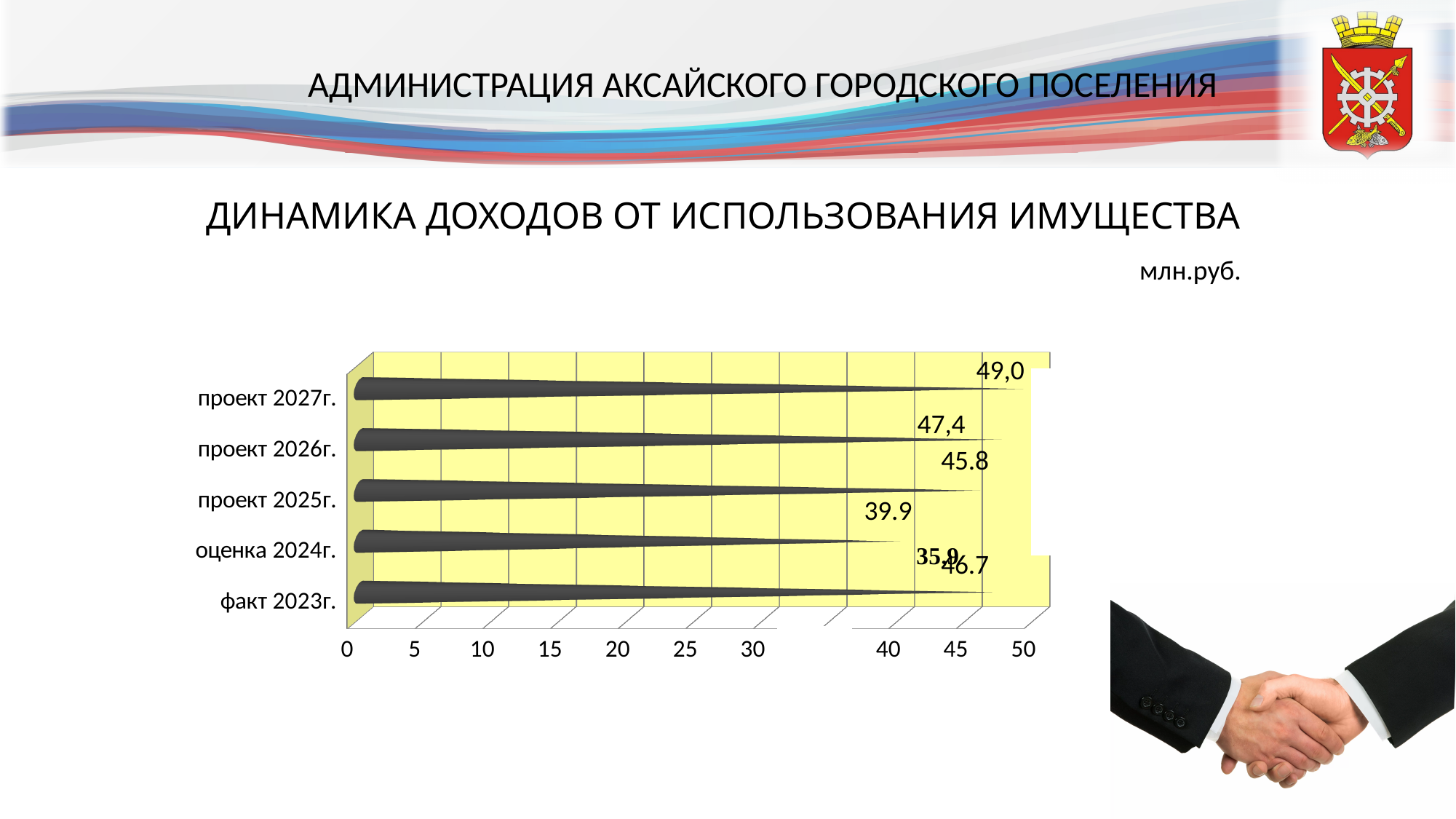
What is the difference between the values for проект 2025г. and оценка 2024г.? 5.9 How many categories are shown in the chart? 5 What is the value for оценка 2024г.? 39.9 What is the difference between the values for проект 2027г. and проект 2026г.? 1,6 Is the value for факт 2023г. greater or less than 40? greater Which is larger, the value for проект 2026г. or проект 2025г.? проект 2026г. Which category has the highest value? проект 2027г. What kind of chart is shown on the slide? bar chart What is the value for проект 2026г.? 47,4 What is the value for проект 2027г.? 49,0 What is the value for проект 2025г.? 45.8 Which category has the lowest value? оценка 2024г.